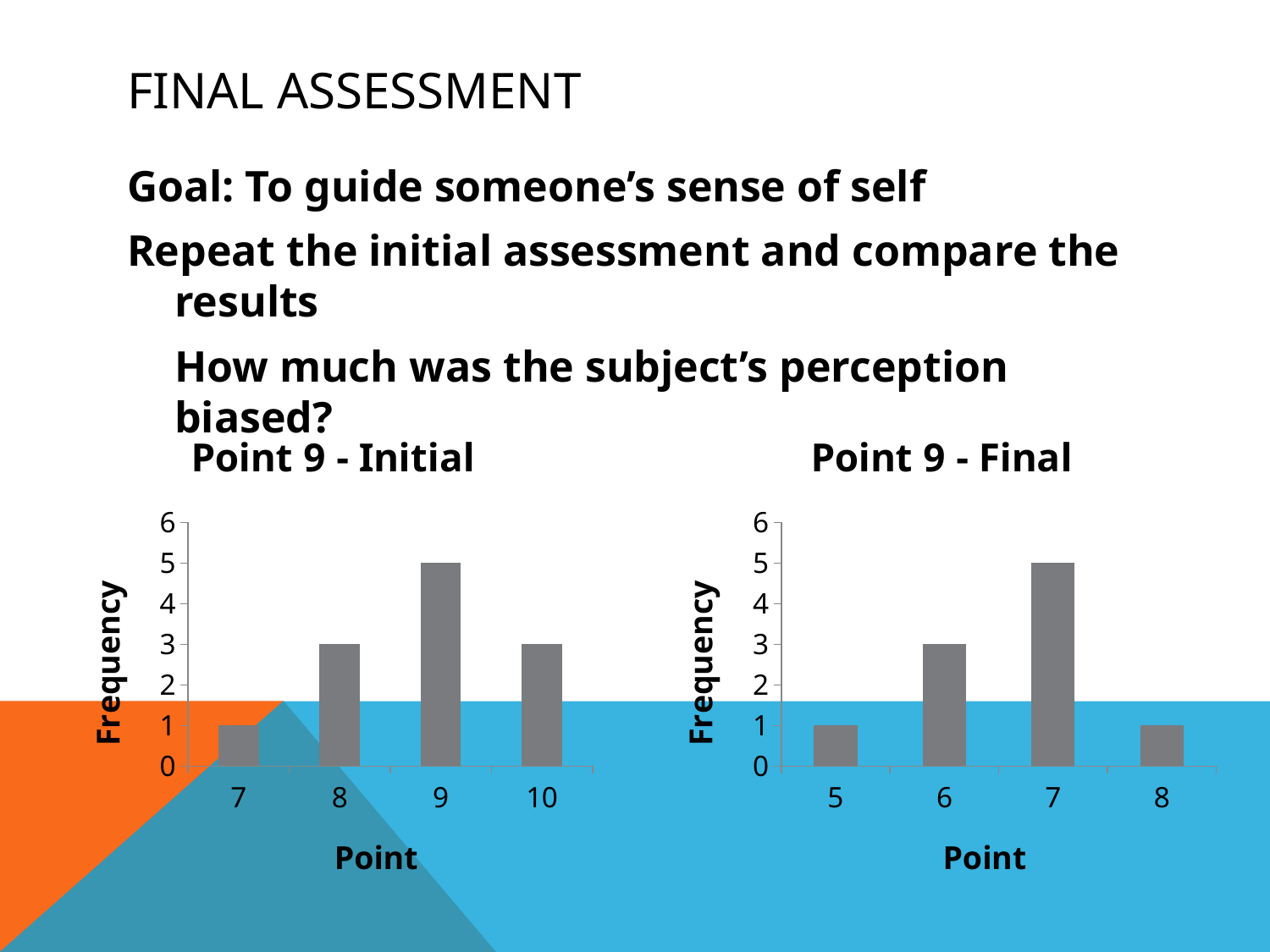
In the 'Point 9 - Final' chart, which point has the highest frequency? 7 In the 'Point 9 - Initial' chart, which point has the lowest frequency? 7 How many points are shown on the x axis of the 'Point 9 - Final' chart? 4 What is the y-axis label of the 'Point 9 - Final' chart? Frequency In the 'Point 9 - Initial' chart, which point has the highest frequency? 9 In the 'Point 9 - Final' chart, what is the frequency for point 8? 1 What kind of chart is the 'Point 9 - Initial' chart? bar chart In the 'Point 9 - Initial' chart, what is the frequency for point 7? 1 In the 'Point 9 - Initial' chart, what is the frequency for point 9? 5 In the 'Point 9 - Final' chart, what is the difference in frequency between point 7 and point 6? 2 In the 'Point 9 - Final' chart, what is the frequency for point 6? 3 In the 'Point 9 - Initial' chart, is the frequency for point 8 larger or smaller than the frequency for point 9? smaller